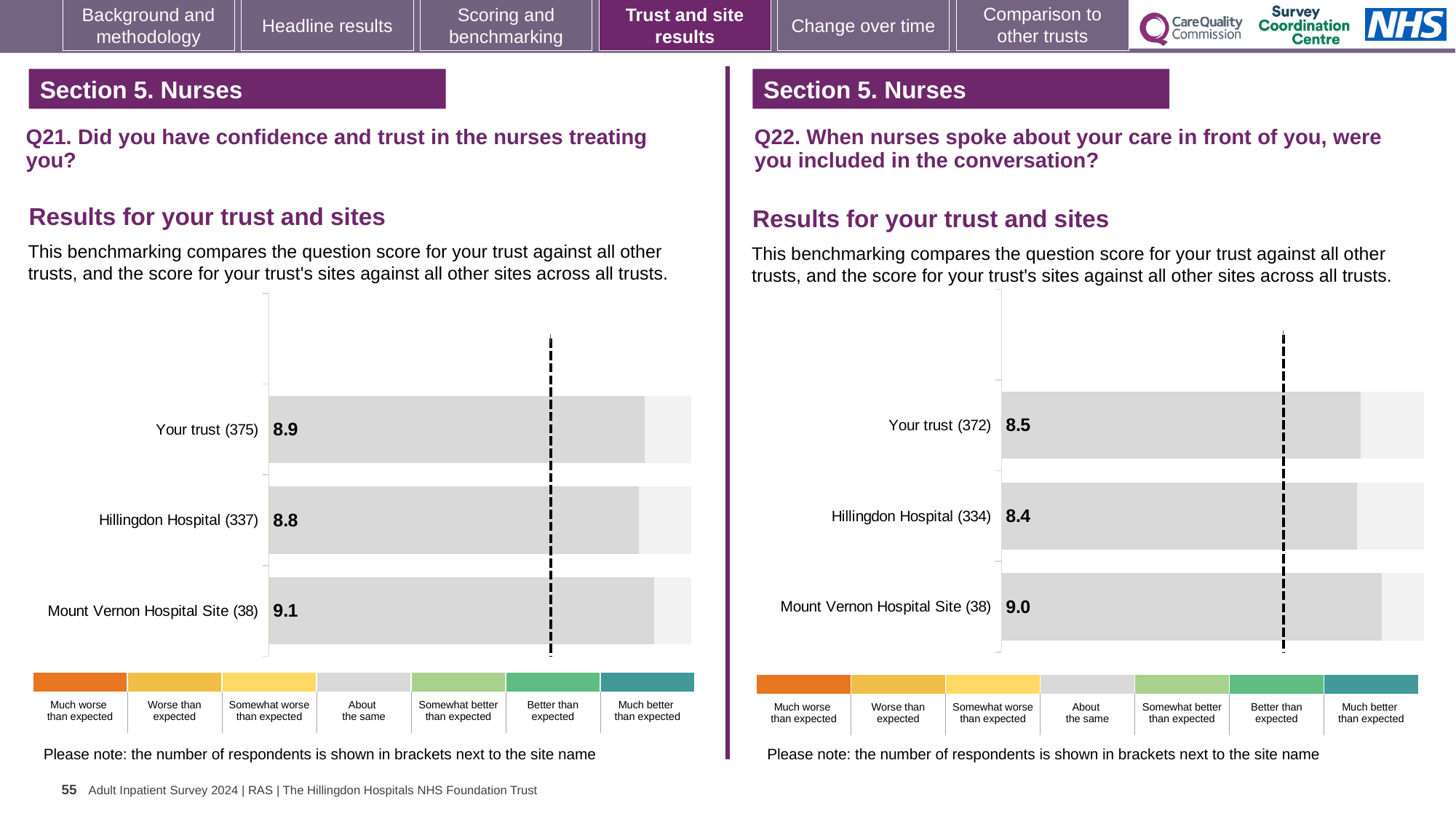
In the Q21 chart on the left, how many respondents are shown in brackets for Hillingdon Hospital? 337 In the Q22 chart on the right, what is the difference between the scores for Mount Vernon Hospital Site and Your trust? 0.5 In the Q21 chart on the left, which site or trust has the highest score? Mount Vernon Hospital Site In the Q22 chart on the right, what is the score for Hillingdon Hospital? 8.4 In the Q22 chart on the right, what is the score for Your trust? 8.5 In the Q21 chart on the left, what is the difference between the scores for Mount Vernon Hospital Site and Hillingdon Hospital? 0.3 In the Q21 chart on the left, what is the score for Your trust? 8.9 In the Q21 chart on the left, what is the score for Mount Vernon Hospital Site? 9.1 In the Q21 chart on the left, which site or trust has the lowest score? Hillingdon Hospital In the Q22 chart on the right, how many bars are plotted? 3 In the Q22 chart on the right, which site or trust has the highest score? Mount Vernon Hospital Site What type of chart is used in the Q21 chart on the left? Bar chart